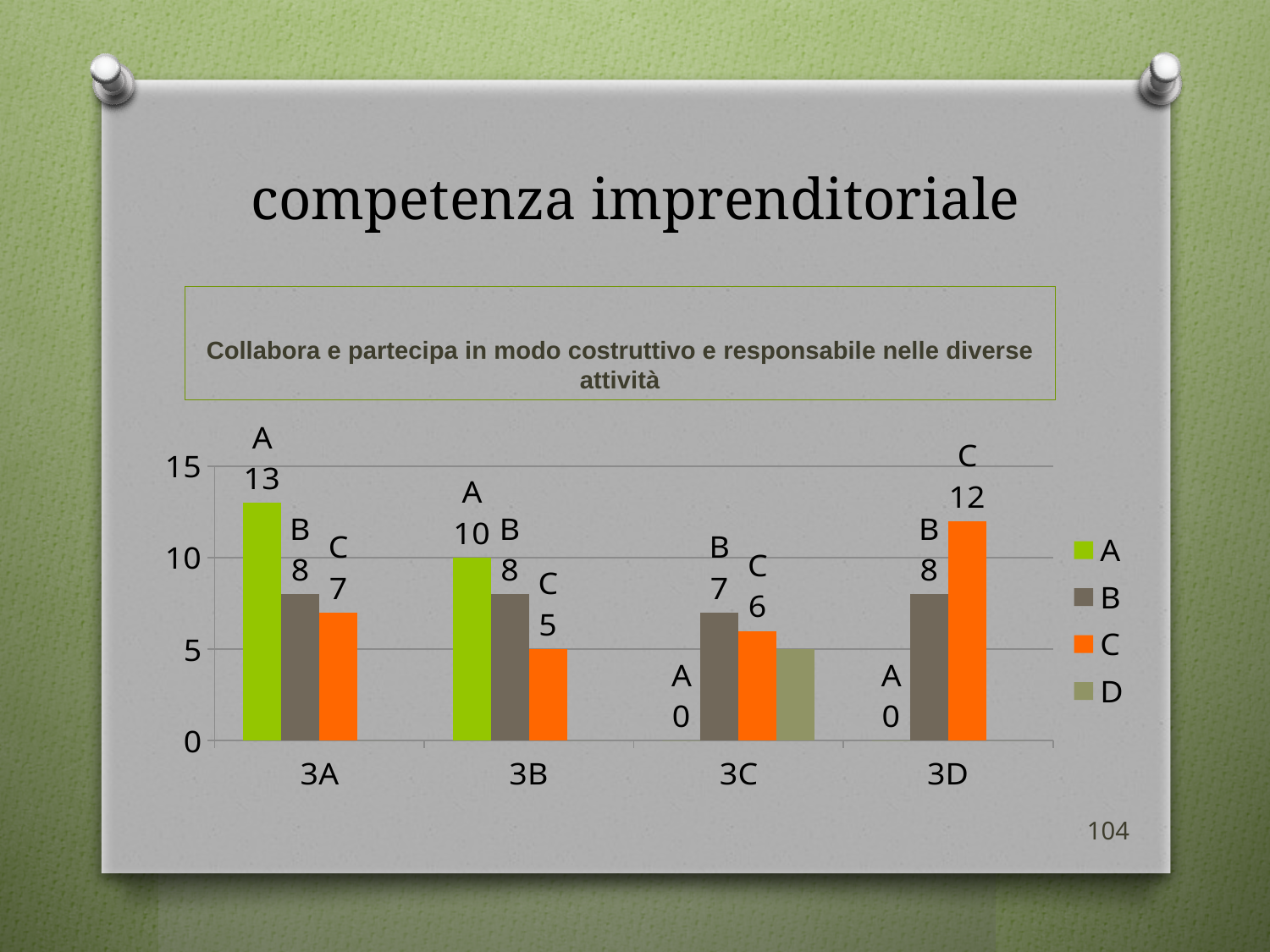
Which category has the lowest value for series C? 3B What colour represents series C in the legend? orange Which category has the highest value for series A? 3A How many categories are shown on the x axis? 4 What is the value of series A for category 3A? 13 What is the value of series B for category 3C? 7 What is the value of series C for category 3D? 12 For category 3D, which is larger: series B or series C? C What kind of chart is shown on the slide? bar chart How many series does the legend list? 4 What is the difference between the values of series A and series C for category 3A? 6 What is the value of series A for category 3D? 0